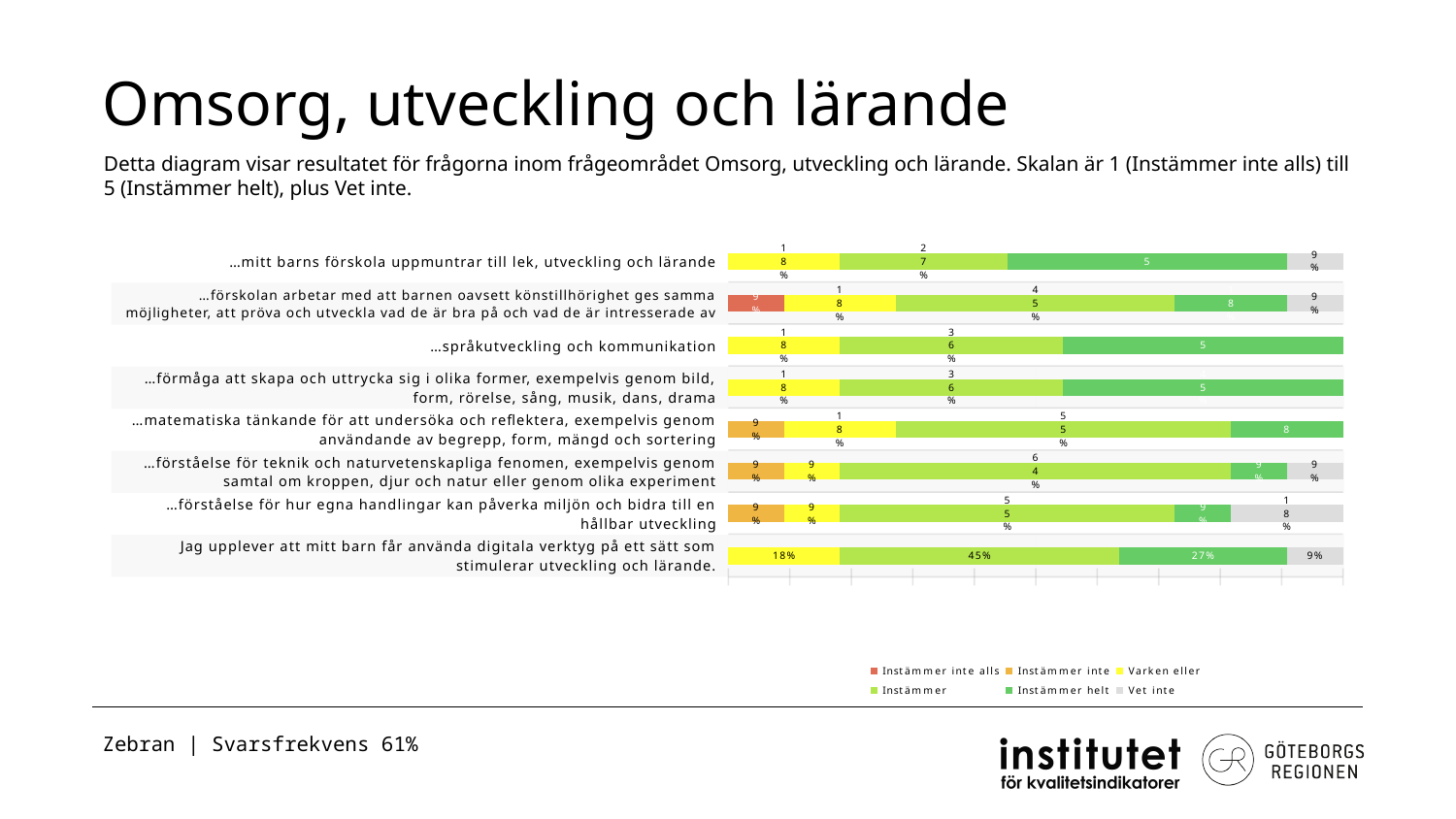
For the statement "Jag upplever att mitt barn får använda digitala verktyg på ett sätt som stimulerar utveckling och lärande.", what is the value for Instämmer helt? 27% For the statement "Jag upplever att mitt barn får använda digitala verktyg på ett sätt som stimulerar utveckling och lärande.", what is the difference between Instämmer (45%) and Instämmer helt (27%)? 18 percentage points For the statement "…mitt barns förskola uppmuntrar till lek, utveckling och lärande", what is the value for Vet inte? 9% For the statement "Jag upplever att mitt barn får använda digitala verktyg på ett sätt som stimulerar utveckling och lärande.", which is larger: Varken eller or Instämmer helt? Instämmer helt For the statement "Jag upplever att mitt barn får använda digitala verktyg på ett sätt som stimulerar utveckling och lärande.", which response category has the largest share? Instämmer For the statement "Jag upplever att mitt barn får använda digitala verktyg på ett sätt som stimulerar utveckling och lärande.", what is the value for Instämmer? 45% For the statement "Jag upplever att mitt barn får använda digitala verktyg på ett sätt som stimulerar utveckling och lärande.", what is the total of the labelled segments 18%, 45%, 27% and 9%? 99% Which legend entry is shown in grey? Vet inte How many series does the legend list? 6 How many question statements (categories) are plotted in the chart? 8 What kind of chart is shown on the slide? Stacked bar chart For the statement "Jag upplever att mitt barn får använda digitala verktyg på ett sätt som stimulerar utveckling och lärande.", what is the value for Vet inte? 9%